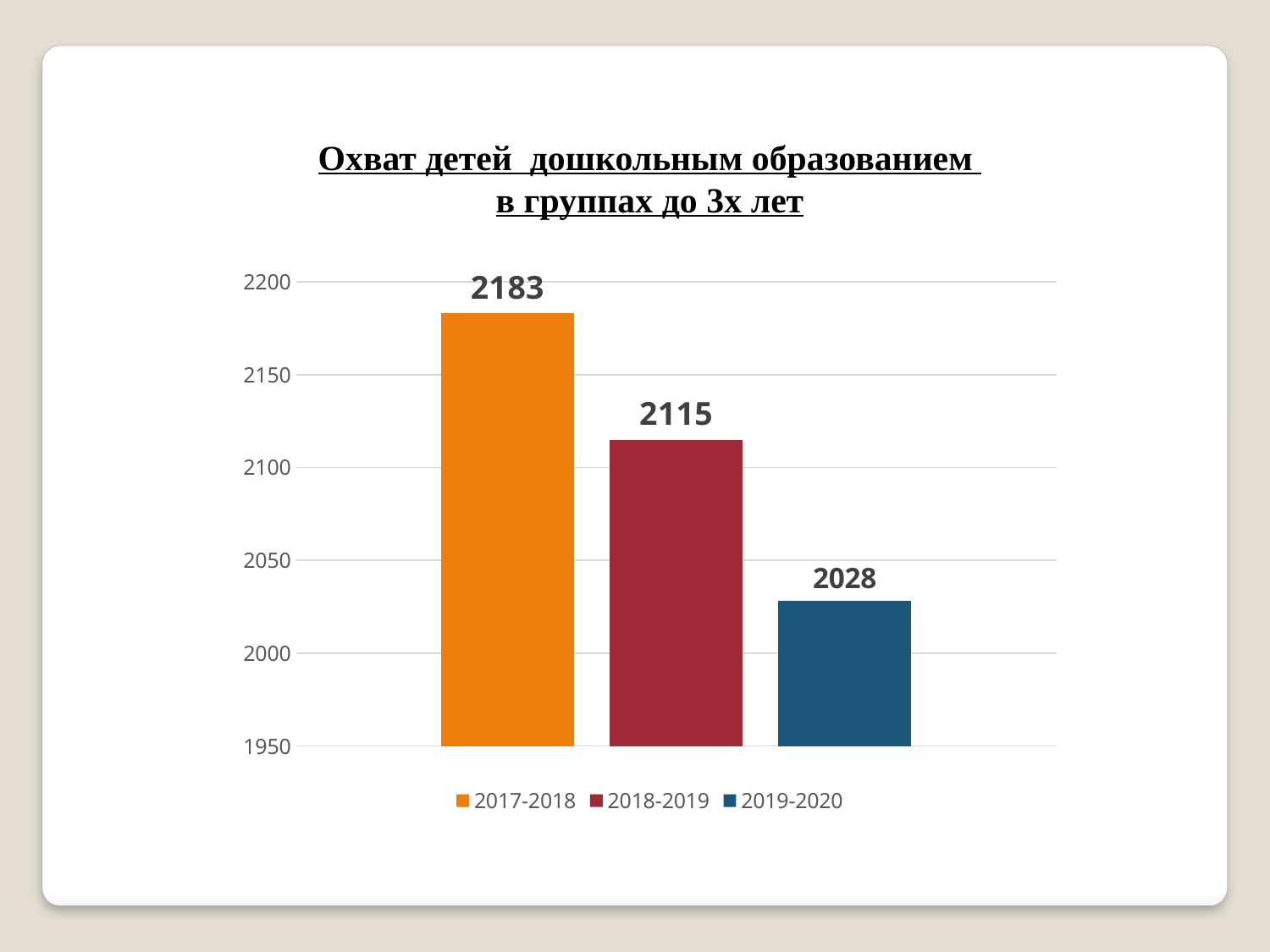
What is the value for 2019-2020? 2028 What is the value for 2018-2019? 2115 What is the difference between the values for 2018-2019 and 2019-2020? 87 Do the values rise or fall from 2017-2018 to 2019-2020? fall How many bars are plotted in the chart? 3 Which period has the highest value? 2017-2018 What is the value for 2017-2018? 2183 Is the value for 2019-2020 greater or less than 2050? less What is the difference between the values for 2017-2018 and 2019-2020? 155 Which period has the lowest value? 2019-2020 What kind of chart is shown on the slide? bar chart Which is larger, the value for 2018-2019 or the value for 2019-2020? 2018-2019